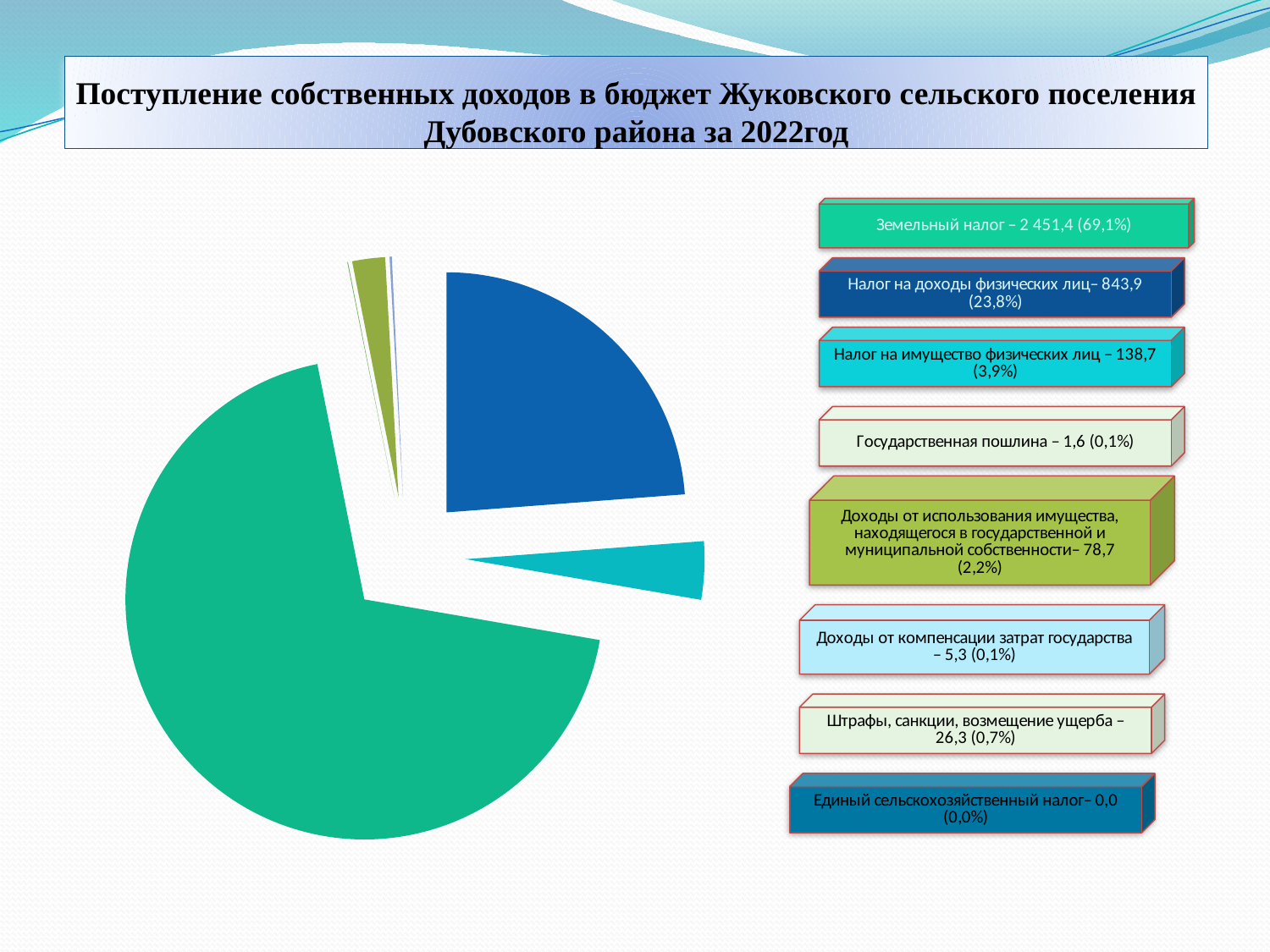
What is the value for Налог на доходы физических лиц? 843,9 Which category has the smallest value? Единый сельскохозяйственный налог What share of the pie does Земельный налог account for? 69,1% What share of the pie does Налог на имущество физических лиц account for? 3,9% Which is larger: Налог на имущество физических лиц or Доходы от использования имущества, находящегося в государственной и муниципальной собственности? Налог на имущество физических лиц What is the difference between the values for Земельный налог and Налог на доходы физических лиц? 1 607,5 Which category has the largest value? Земельный налог How many categories are listed in the legend? 8 What is the value for Земельный налог? 2 451,4 What is the title of the slide? Поступление собственных доходов в бюджет Жуковского сельского поселения Дубовского района за 2022год What is the value for Штрафы, санкции, возмещение ущерба? 26,3 What kind of chart is shown on the slide? pie chart